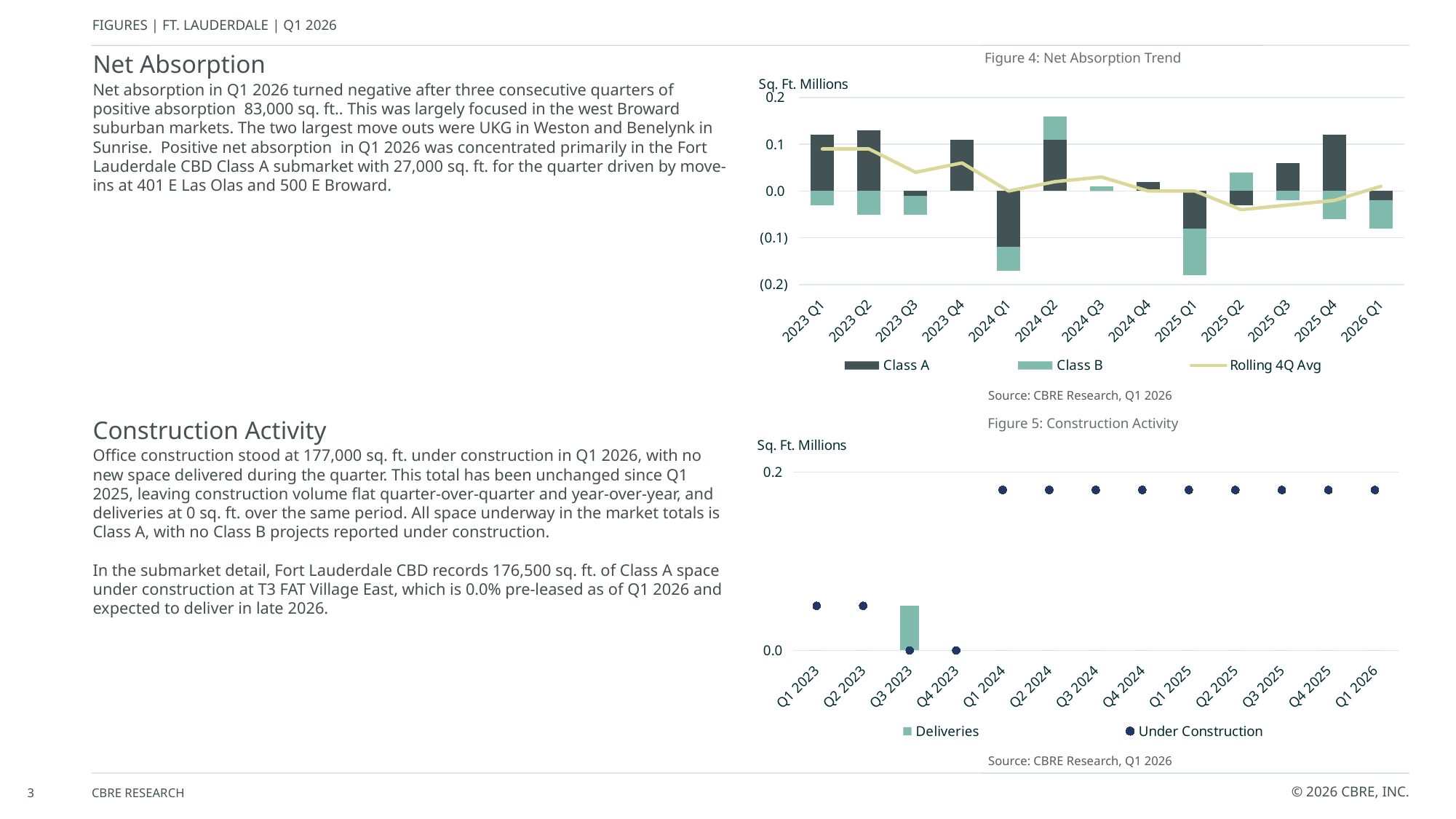
In Figure 4: Net Absorption Trend, in which quarter is the Class A value lowest? 2024 Q1 In Figure 4: Net Absorption Trend, is the Class A value for 2023 Q1 greater or less than 0.1? greater In Figure 5: Construction Activity, is the Under Construction value for Q1 2026 greater or less than 0.1? greater In Figure 4: Net Absorption Trend, what is the unit shown on the y axis? Sq. Ft. Millions In Figure 4: Net Absorption Trend, is the total stacked bar for 2025 Q1 greater or less than (0.1)? less In Figure 4: Net Absorption Trend, how many series does the legend list? 3 In Figure 4: Net Absorption Trend, what kind of chart is used to show Class A and Class B? Stacked bar chart In Figure 5: Construction Activity, in which quarter is the only Deliveries bar shown? Q3 2023 In Figure 4: Net Absorption Trend, in which quarter is the Class B value lowest? 2025 Q1 In Figure 5: Construction Activity, does the Under Construction value rise or fall from Q4 2023 to Q1 2024? rise In Figure 4: Net Absorption Trend, how many quarters are shown on the x axis? 13 In Figure 5: Construction Activity, how many series does the legend list? 2